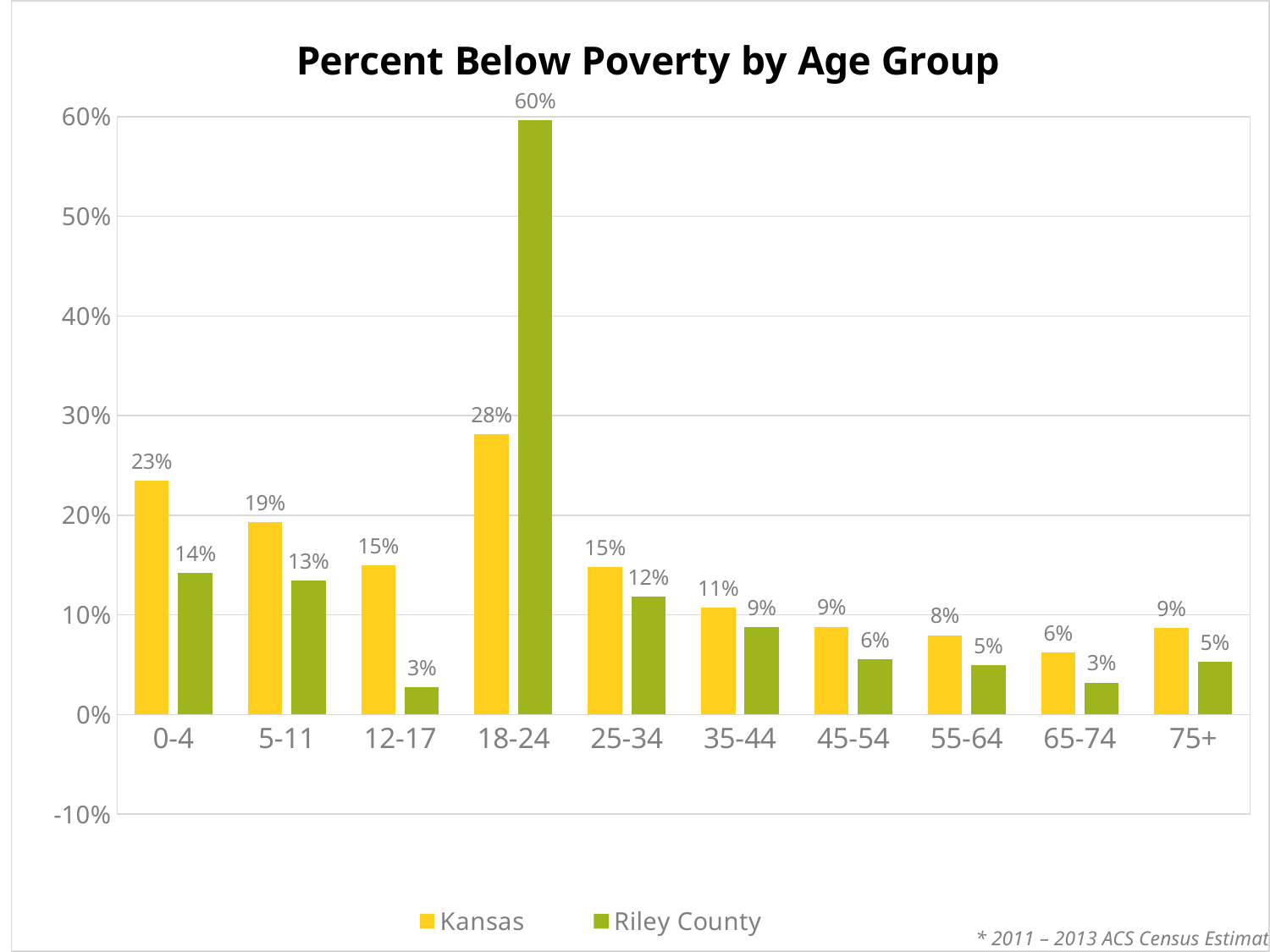
What is the title of the chart? Percent Below Poverty by Age Group What kind of chart is shown on the slide? Bar chart What is the Kansas value for the 0-4 age group? 23% Which age group has the lowest Riley County value? 12-17 and 65-74 (both 3%) For the 5-11 age group, which is larger: the Kansas value or the Riley County value? Kansas What is the Riley County value for the 12-17 age group? 3% How many age groups are shown on the x axis? 10 How many series does the legend list? 2 Is the Riley County value for the 18-24 age group greater or less than 50%? greater What is the difference between the Riley County and Kansas values for the 18-24 age group? 32% Which age group has the highest Riley County value? 18-24 What is the Riley County value for the 18-24 age group? 60%